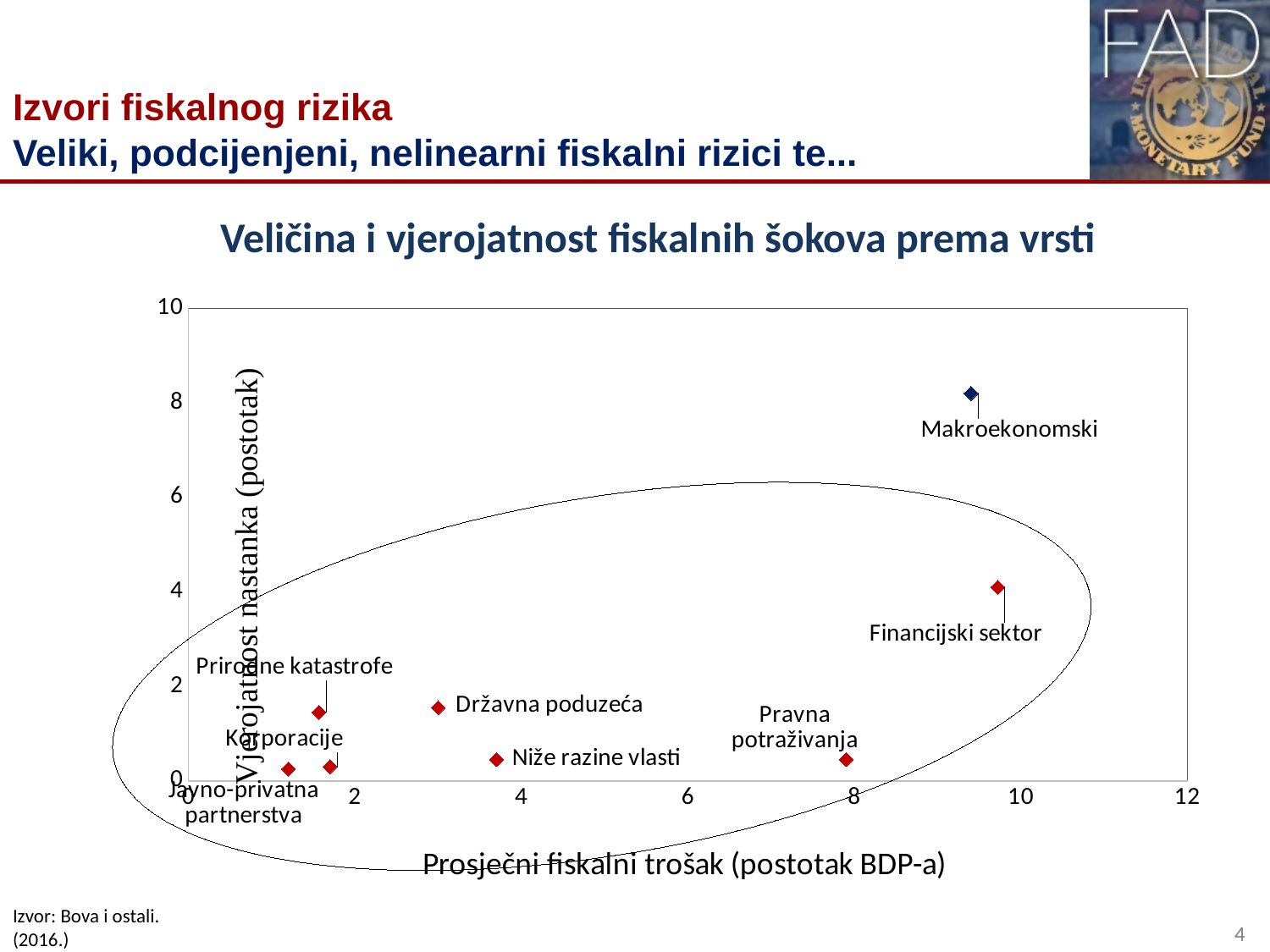
Which risk type has the highest probability of occurrence (Vjerojatnost nastanka) on the chart? Makroekonomski Which has a larger average fiscal cost, Pravna potraživanja or Državna poduzeća? Pravna potraživanja Is the average fiscal cost for Državna poduzeća greater or less than 4? less What is the label of the horizontal axis of the chart? Prosječni fiskalni trošak (postotak BDP-a) Is the average fiscal cost for Pravna potraživanja greater or less than 6? greater Which has a higher probability of occurrence, Makroekonomski or Financijski sektor? Makroekonomski Is the probability of occurrence for Niže razine vlasti greater or less than 2? less What kind of chart is shown on the slide? Scatter chart What is the title of the chart? Veličina i vjerojatnost fiskalnih šokova prema vrsti How many labeled data points are plotted on the chart? 8